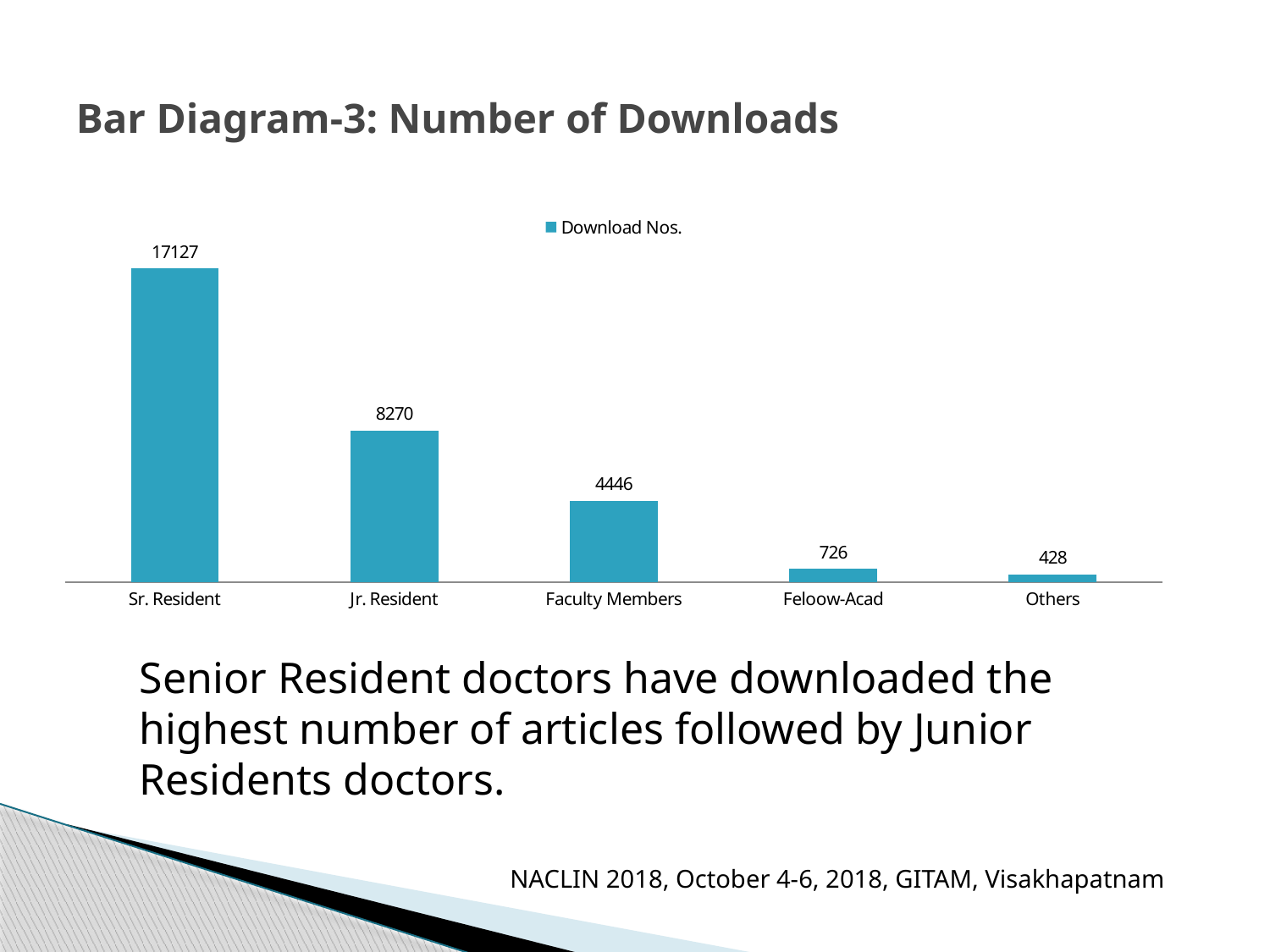
Which has more downloads, Jr. Resident or Faculty Members? Jr. Resident What is the number of downloads for Faculty Members? 4446 Which category has the lowest number of downloads? Others What is the name of the series shown in the legend? Download Nos. What kind of chart is shown on the slide? Bar chart What is the difference in downloads between Feloow-Acad and Others? 298 What is the number of downloads for Others? 428 How many series does the legend list? 1 Which category has the highest number of downloads? Sr. Resident What is the number of downloads for Sr. Resident? 17127 How many categories are shown on the x axis? 5 What is the difference in downloads between Sr. Resident and Jr. Resident? 8857